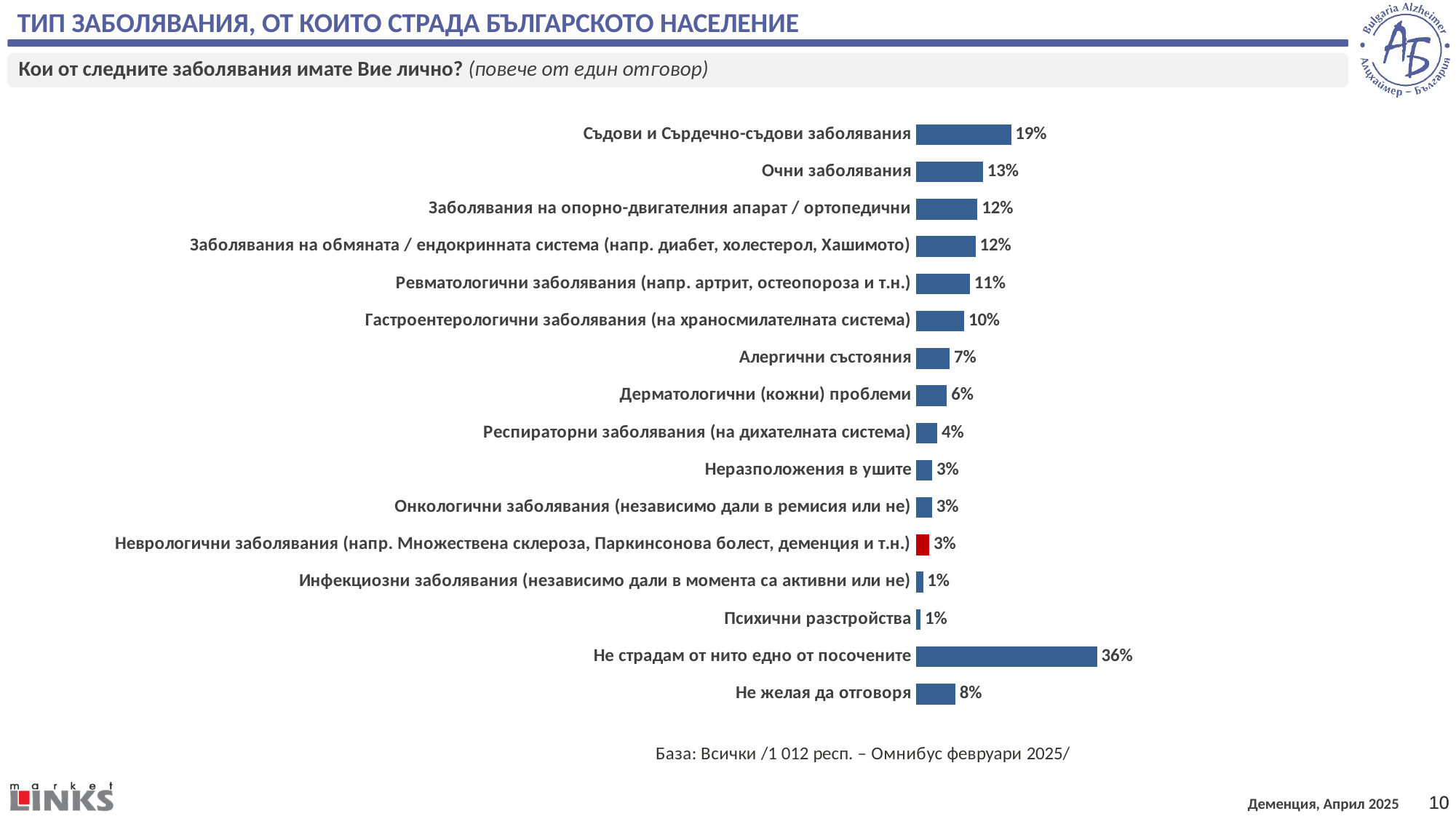
What percentage is shown for Неврологични заболявания (напр. Множествена склероза, Паркинсонова болест, деменция и т.н.)? 3% How many categories are shown in the chart? 16 Which category's bar is coloured red instead of blue? Неврологични заболявания (напр. Множествена склероза, Паркинсонова болест, деменция и т.н.) What is the difference between the values for Съдови и Сърдечно-съдови заболявания and Очни заболявания? 6% Which is larger: the value for Алергични състояния or the value for Дерматологични (кожни) проблеми? Алергични състояния What is the value for Не желая да отговоря? 8% Which category has the highest value in the chart? Не страдам от нито едно от посочените What percentage of respondents report having Съдови и Сърдечно-съдови заболявания? 19% What is the difference between Не страдам от нито едно от посочените and Съдови и Сърдечно-съдови заболявания? 17% Which is larger: the value for Гастроентерологични заболявания or the value for Ревматологични заболявания? Ревматологични заболявания What type of chart is shown on the slide? Bar chart What is the value shown for Очни заболявания? 13%